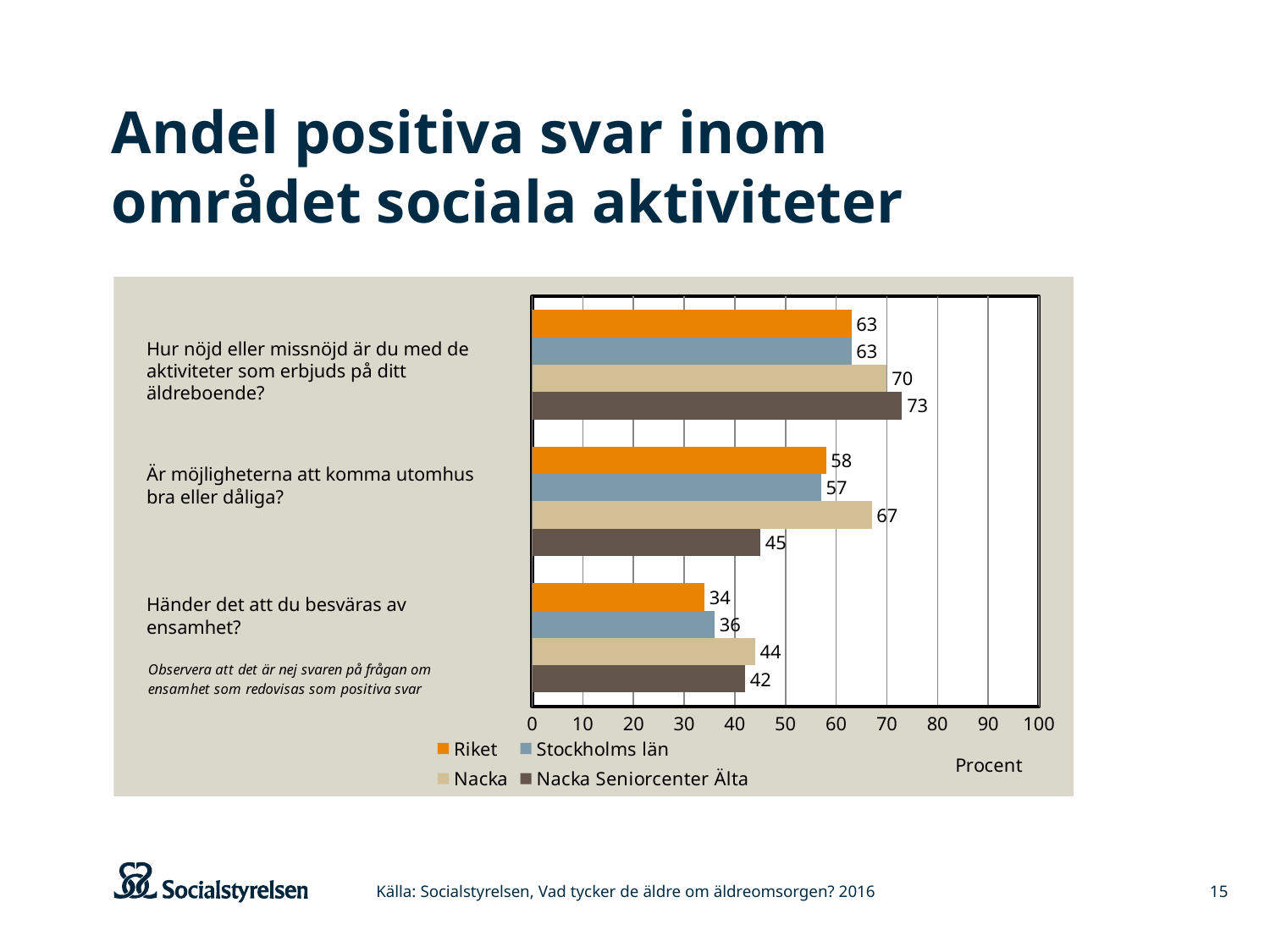
What is the value for Nacka on the question "Är möjligheterna att komma utomhus bra eller dåliga?"? 67 How many questions (categories) are shown on the chart? 3 What kind of chart is shown on the slide? bar chart What is the difference between Nacka Seniorcenter Älta and Riket on the question "Hur nöjd eller missnöjd är du med de aktiviteter som erbjuds på ditt äldreboende?"? 10 Which series has the highest value on the question "Är möjligheterna att komma utomhus bra eller dåliga?"? Nacka What is the value for Nacka Seniorcenter Älta on the question "Hur nöjd eller missnöjd är du med de aktiviteter som erbjuds på ditt äldreboende?"? 73 How many series does the legend list? 4 Which is larger on the question "Händer det att du besväras av ensamhet?": Nacka or Nacka Seniorcenter Älta? Nacka What is the value for Riket on the question "Händer det att du besväras av ensamhet?"? 34 Which series has the lowest value on the question "Är möjligheterna att komma utomhus bra eller dåliga?"? Nacka Seniorcenter Älta Is the value for Stockholms län on the question "Är möjligheterna att komma utomhus bra eller dåliga?" greater or less than 50? greater What is the label of the horizontal axis? Procent